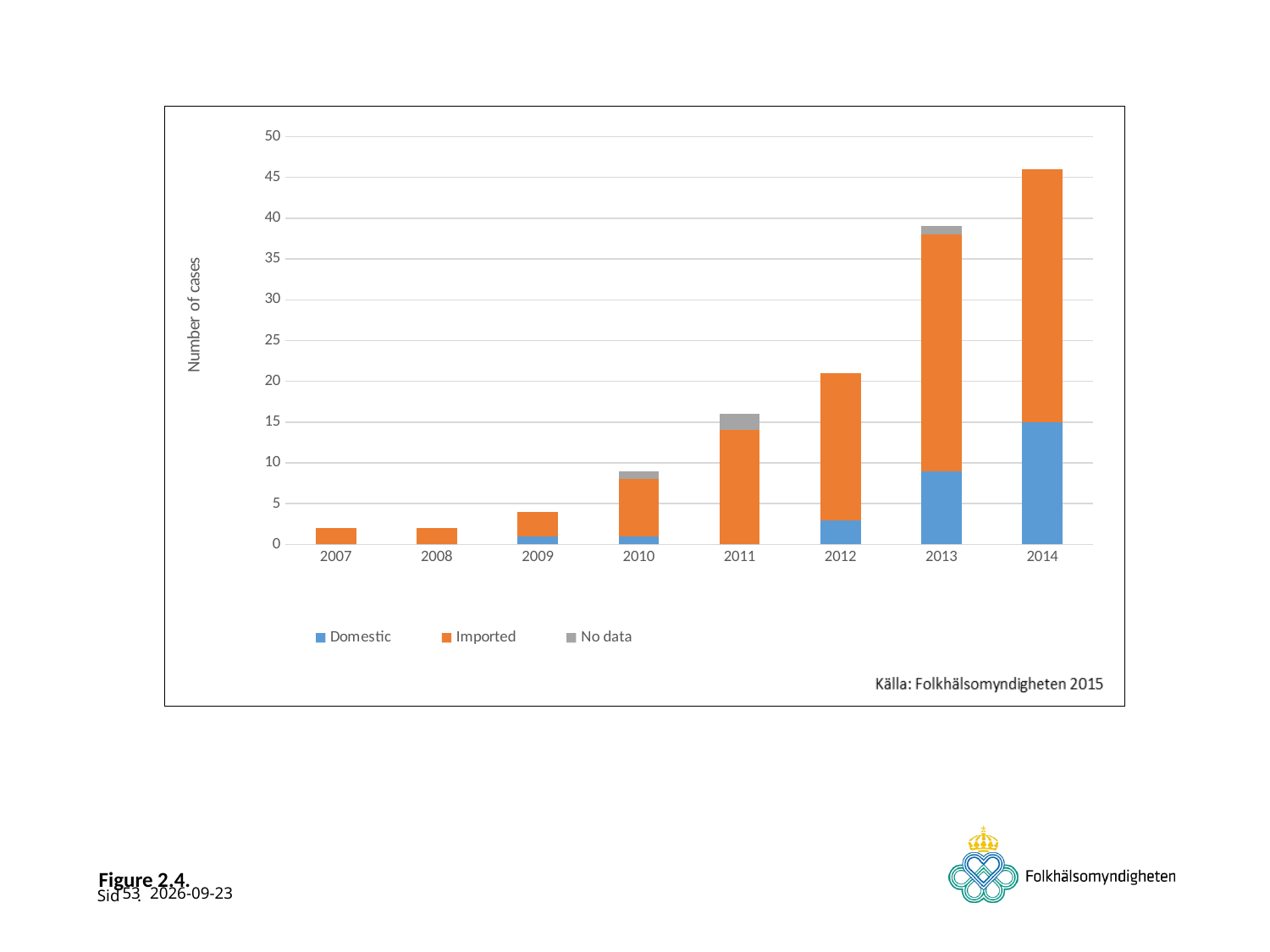
Is the total number of cases in 2011 greater or less than 20? less Do the total number of cases generally rise or fall from 2007 to 2014? rise What are the three series listed in the chart's legend? Domestic, Imported, No data How many years are shown on the x axis of the chart? 8 Is the total number of cases in 2013 greater or less than 35? greater What is the label on the y axis of the chart? Number of cases How many series does the chart's legend list? 3 Which year has the highest total number of cases? 2014 Is the Domestic value for 2014 greater or less than 10? greater Which year has the larger total number of cases, 2012 or 2013? 2013 What kind of chart is shown on the slide? Stacked bar chart